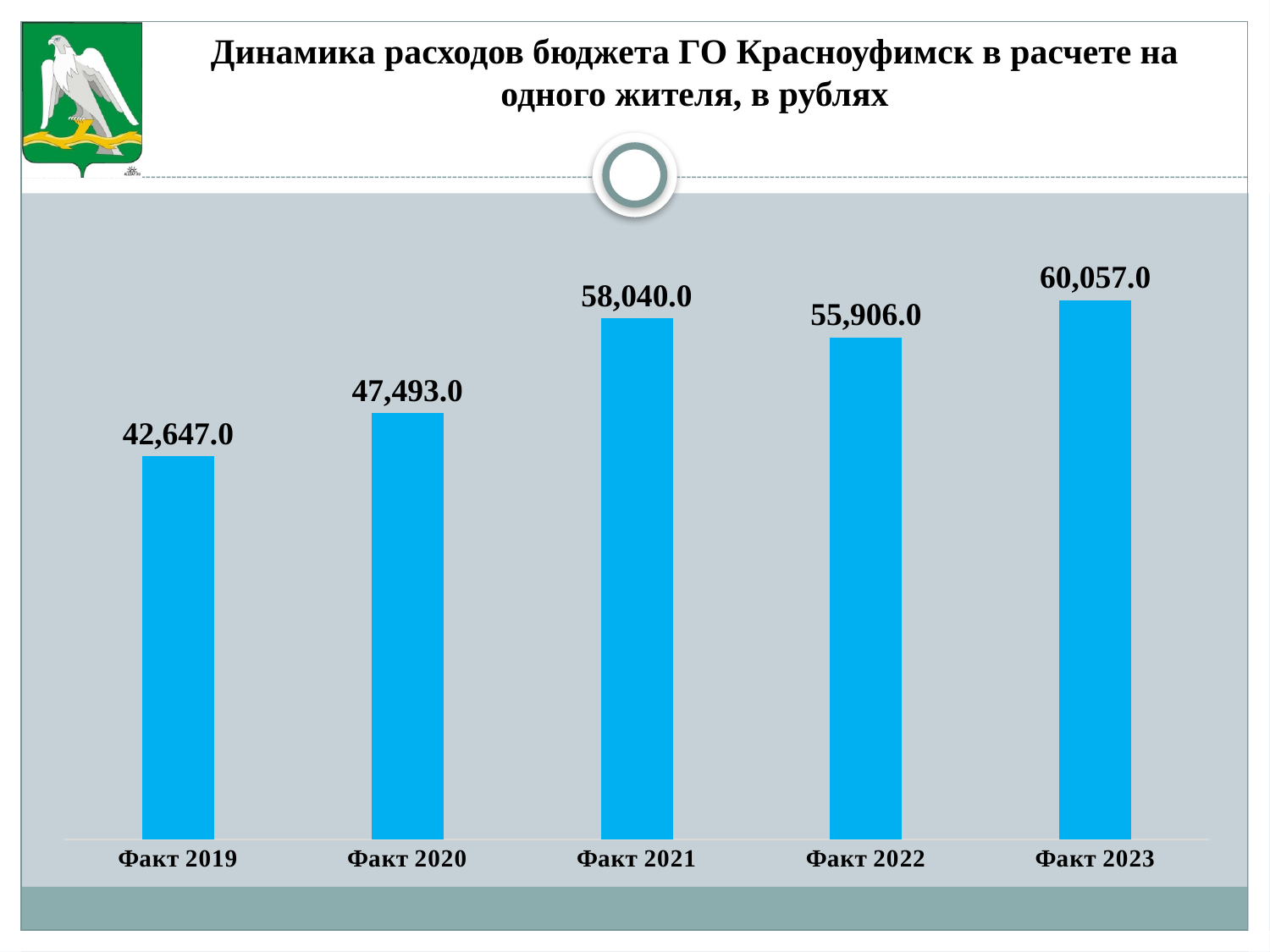
What is the title of the chart? Динамика расходов бюджета ГО Красноуфимск в расчете на одного жителя, в рублях Which category has the lowest value? Факт 2019 What is the value for Факт 2021? 58,040.0 What is the value for Факт 2019? 42,647.0 What kind of chart is shown on the slide? Bar chart Which category has the highest value? Факт 2023 What is the difference between the values for Факт 2021 and Факт 2022? 2,134.0 How many categories are shown on the chart? 5 Do the values generally rise or fall from Факт 2019 to Факт 2023? Rise What is the difference between the values for Факт 2023 and Факт 2019? 17,410.0 Which is larger, the value for Факт 2021 or Факт 2022? Факт 2021 What is the value for Факт 2023? 60,057.0